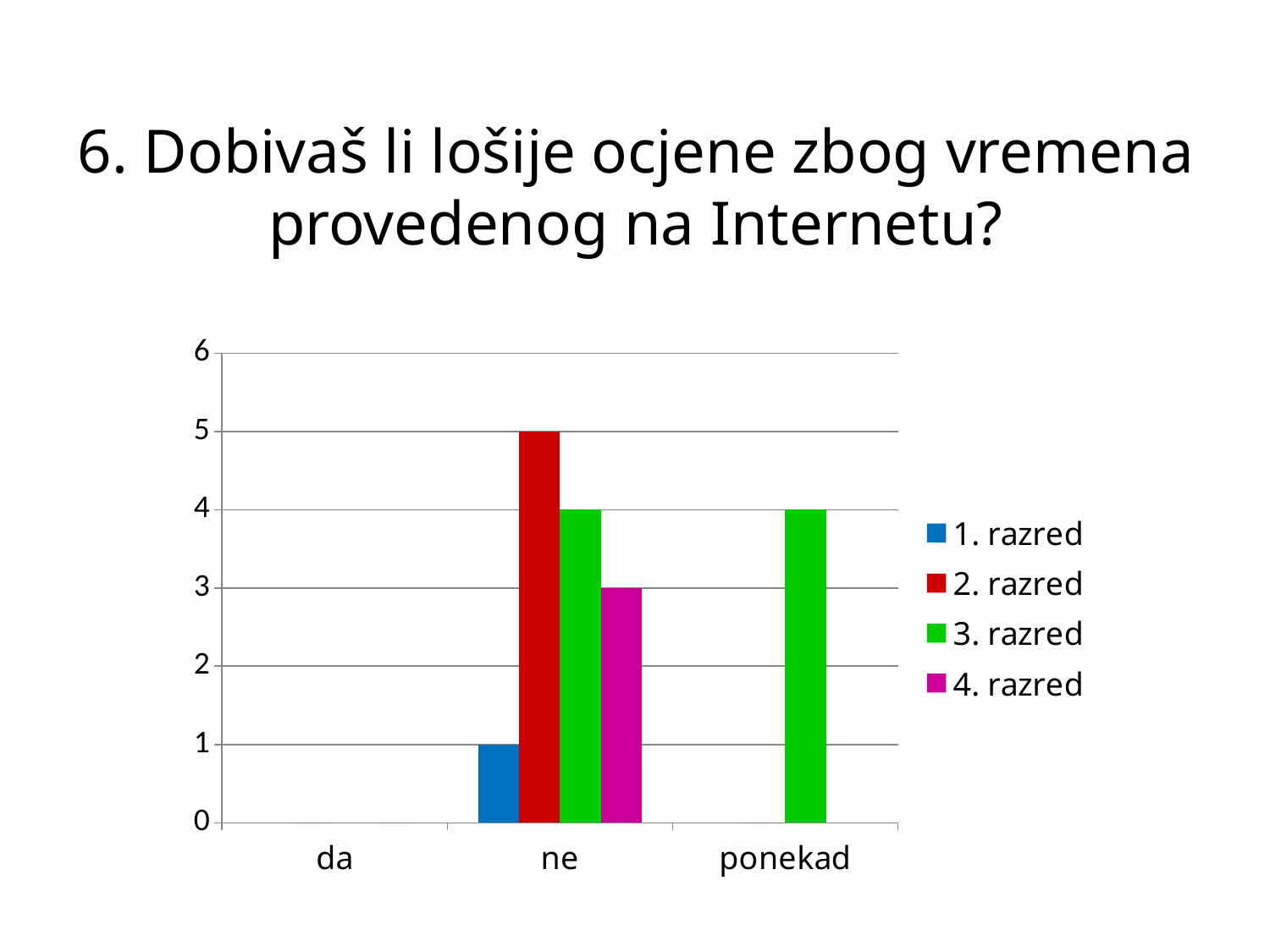
Which series has the lowest value in the 'ne' category? 1. razred What is the value for 3. razred in the 'ponekad' category? 4 What is the value for 2. razred in the 'ne' category? 5 How many categories are shown on the x axis? 3 What kind of chart is shown on the slide? bar chart Which series is shown in green in the legend? 3. razred How many series does the legend list? 4 What is the difference between the values for 2. razred and 4. razred in the 'ne' category? 2 In the 'ne' category, which is larger: the value for 3. razred or the value for 4. razred? 3. razred What is the value for 1. razred in the 'ne' category? 1 Which series has the highest value in the 'ne' category? 2. razred What is the value for 4. razred in the 'ne' category? 3